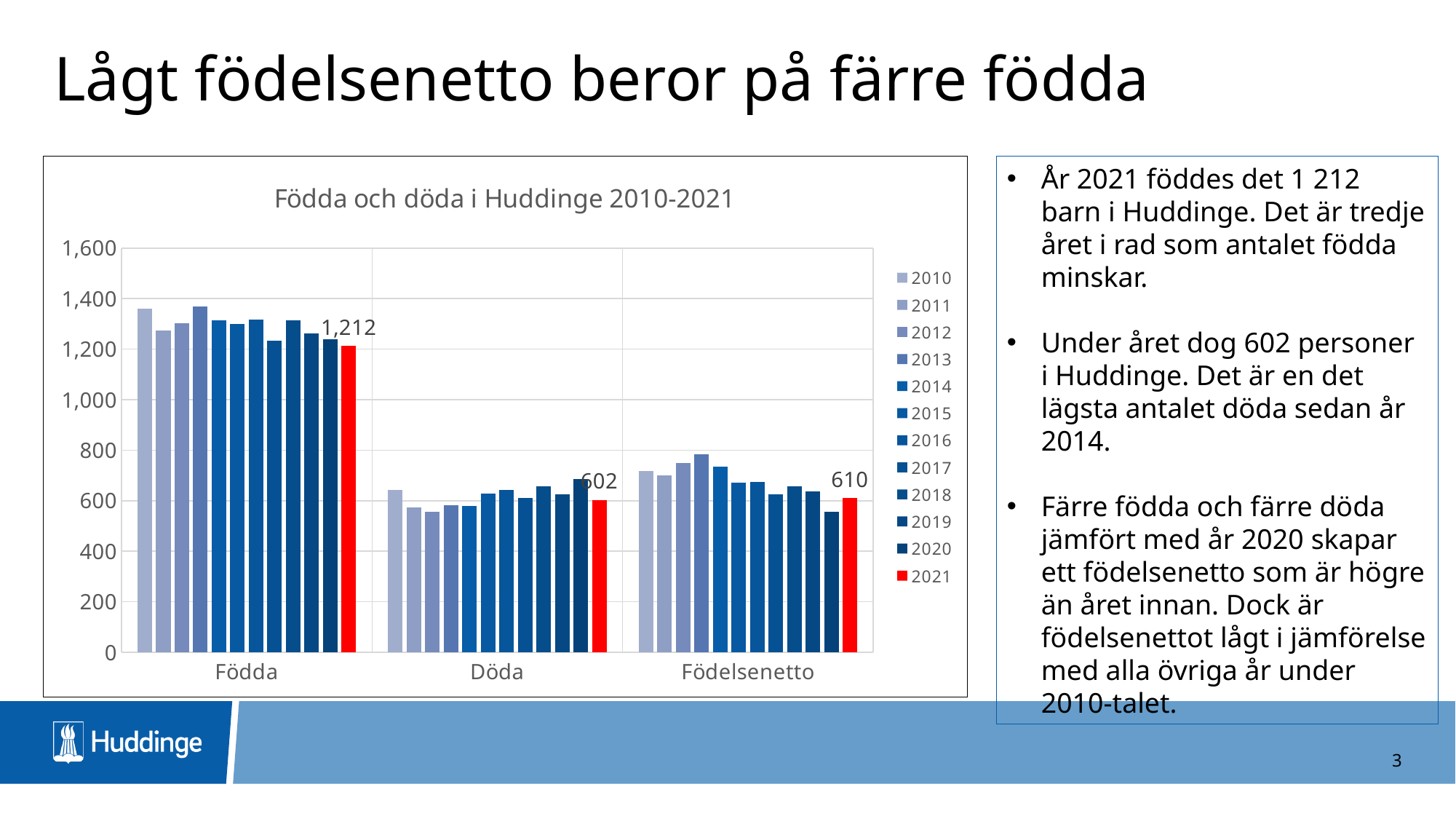
What kind of chart is shown on the slide? Bar chart Which year has the lowest value for Födelsenetto? 2020 How many categories are shown on the x axis? 3 What is the value for Födelsenetto in 2021? 610 What is the title of the chart? Födda och döda i Huddinge 2010-2021 What is the difference between the 2021 values for Födda and Döda? 610 How many series does the legend list? 12 Which is larger in 2021, Döda or Födelsenetto? Födelsenetto Is the value for Födda in 2010 greater or less than 1,200? greater Is the value for Döda in 2012 greater or less than 600? less What is the value for Döda in 2021? 602 What is the value for Födda in 2021? 1,212